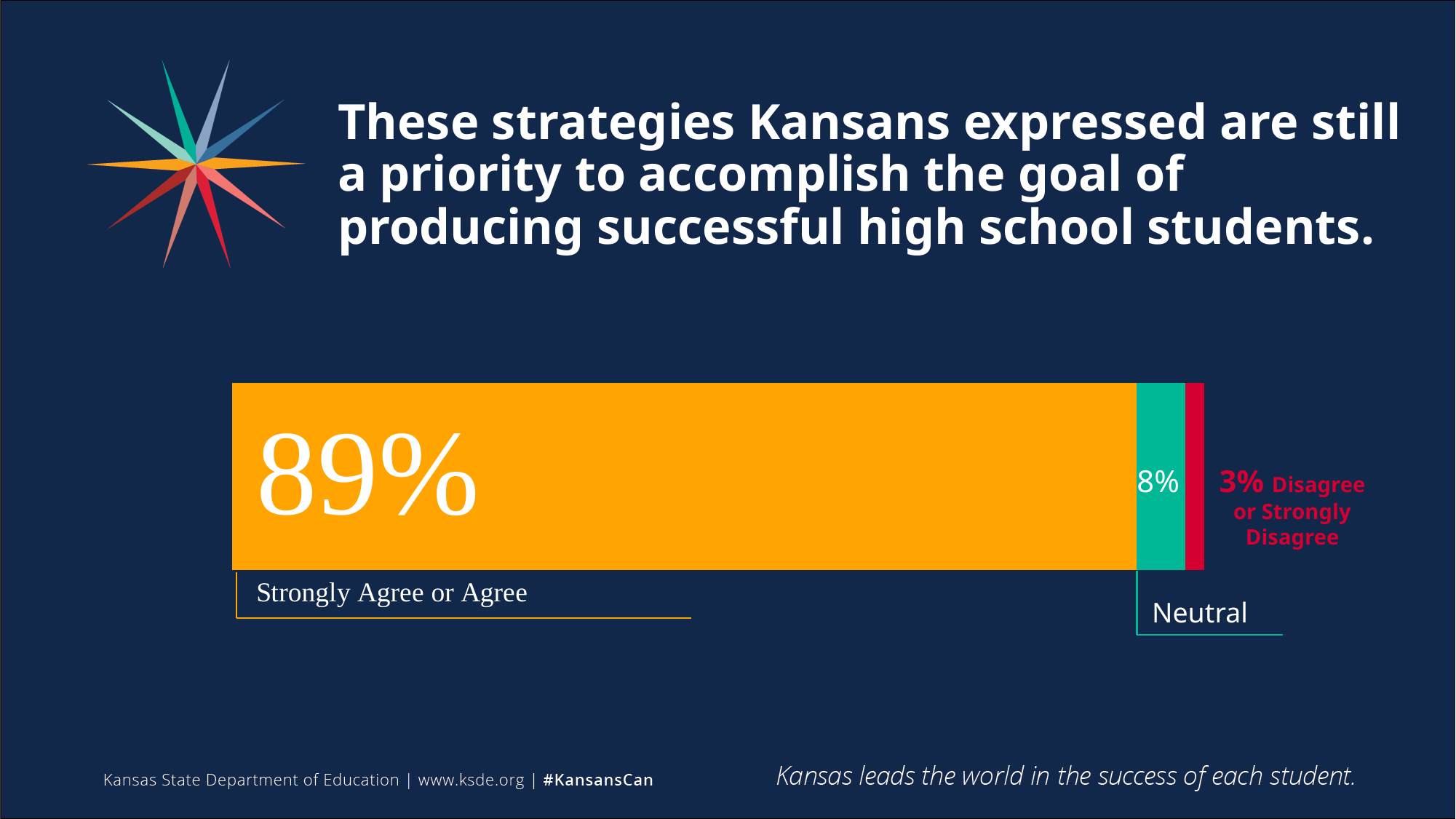
What colour is the Neutral segment of the bar? Teal Which response category has the largest share? Strongly Agree or Agree How many response categories are shown in the bar? 3 Which is larger, the Neutral share or the Disagree or Strongly Disagree share? Neutral What percentage of respondents answered Neutral? 8% What percentage of respondents answered Disagree or Strongly Disagree? 3% What is the total of the three segments in the stacked bar? 100% What kind of chart is shown on the slide? Stacked bar chart What percentage of respondents answered Strongly Agree or Agree? 89% Which response category has the smallest share? Disagree or Strongly Disagree What is the difference between the Neutral share and the Disagree or Strongly Disagree share? 5% What is the difference between the Strongly Agree or Agree share and the Neutral share? 81%